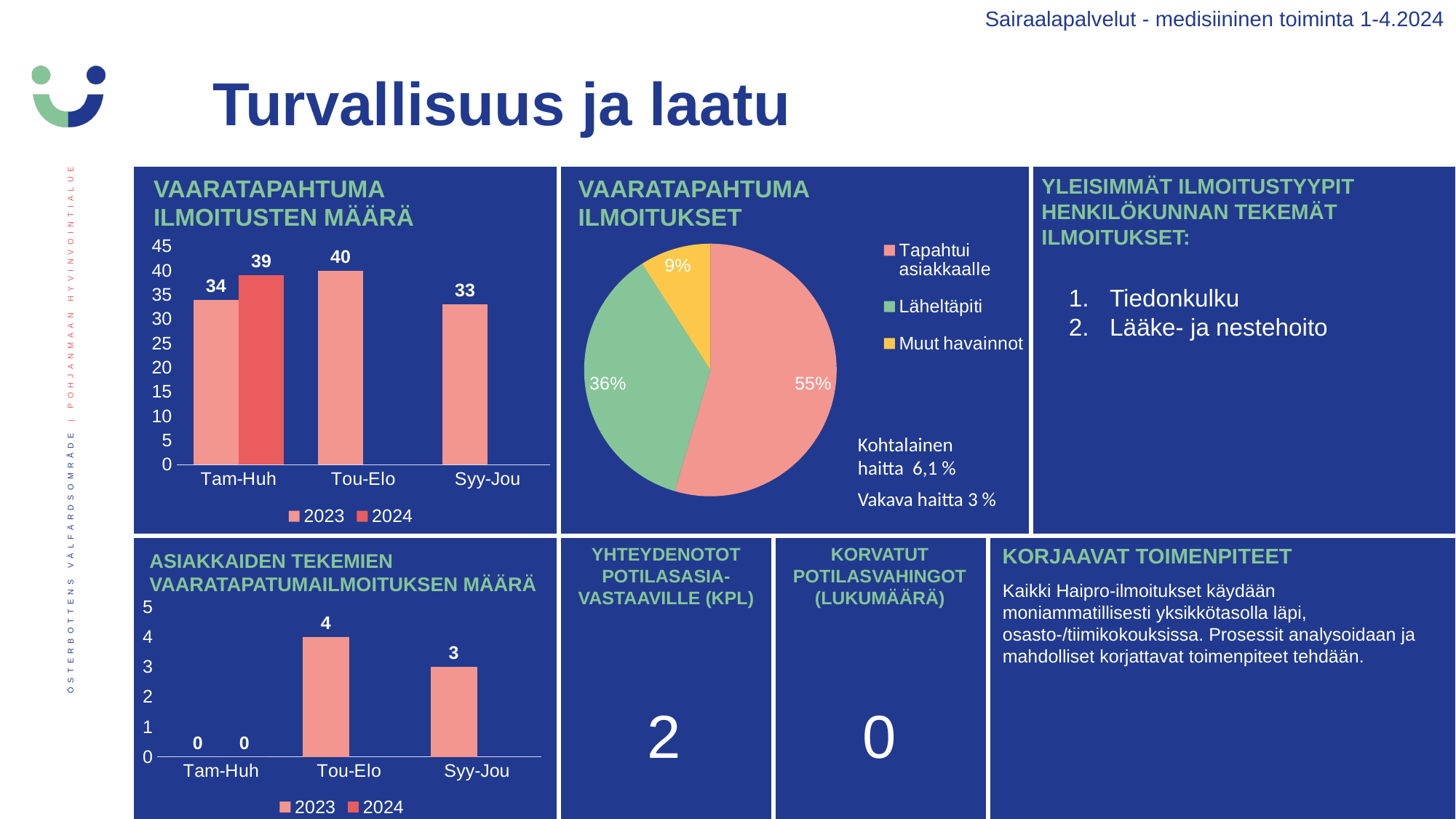
In the chart titled ASIAKKAIDEN TEKEMIEN VAARATAPATUMAILMOITUKSEN MÄÄRÄ, what is the 2023 value for Tou-Elo? 4 In the chart titled VAARATAPAHTUMA ILMOITUSTEN MÄÄRÄ, what is the difference between the 2024 and 2023 values for Tam-Huh? 5 In the chart titled VAARATAPAHTUMA ILMOITUSTEN MÄÄRÄ, is the 2023 value for Tou-Elo greater or less than 35? greater In the pie chart titled VAARATAPAHTUMA ILMOITUKSET, how many slices are there? 3 In the pie chart titled VAARATAPAHTUMA ILMOITUKSET, what share is Läheltäpiti? 36% In the chart titled VAARATAPAHTUMA ILMOITUSTEN MÄÄRÄ, what is the 2024 value for Tam-Huh? 39 In the chart titled VAARATAPAHTUMA ILMOITUSTEN MÄÄRÄ, what is the 2023 value for Tou-Elo? 40 In the chart titled VAARATAPAHTUMA ILMOITUSTEN MÄÄRÄ, how many series does the legend list? 2 In the pie chart titled VAARATAPAHTUMA ILMOITUKSET, which category has the largest slice? Tapahtui asiakkaalle What kind of chart is the one titled VAARATAPAHTUMA ILMOITUKSET? pie chart In the chart titled ASIAKKAIDEN TEKEMIEN VAARATAPATUMAILMOITUKSEN MÄÄRÄ, which is larger, the 2023 value for Tou-Elo or for Syy-Jou? Tou-Elo In the chart titled VAARATAPAHTUMA ILMOITUSTEN MÄÄRÄ, which period has the lowest 2023 value? Syy-Jou